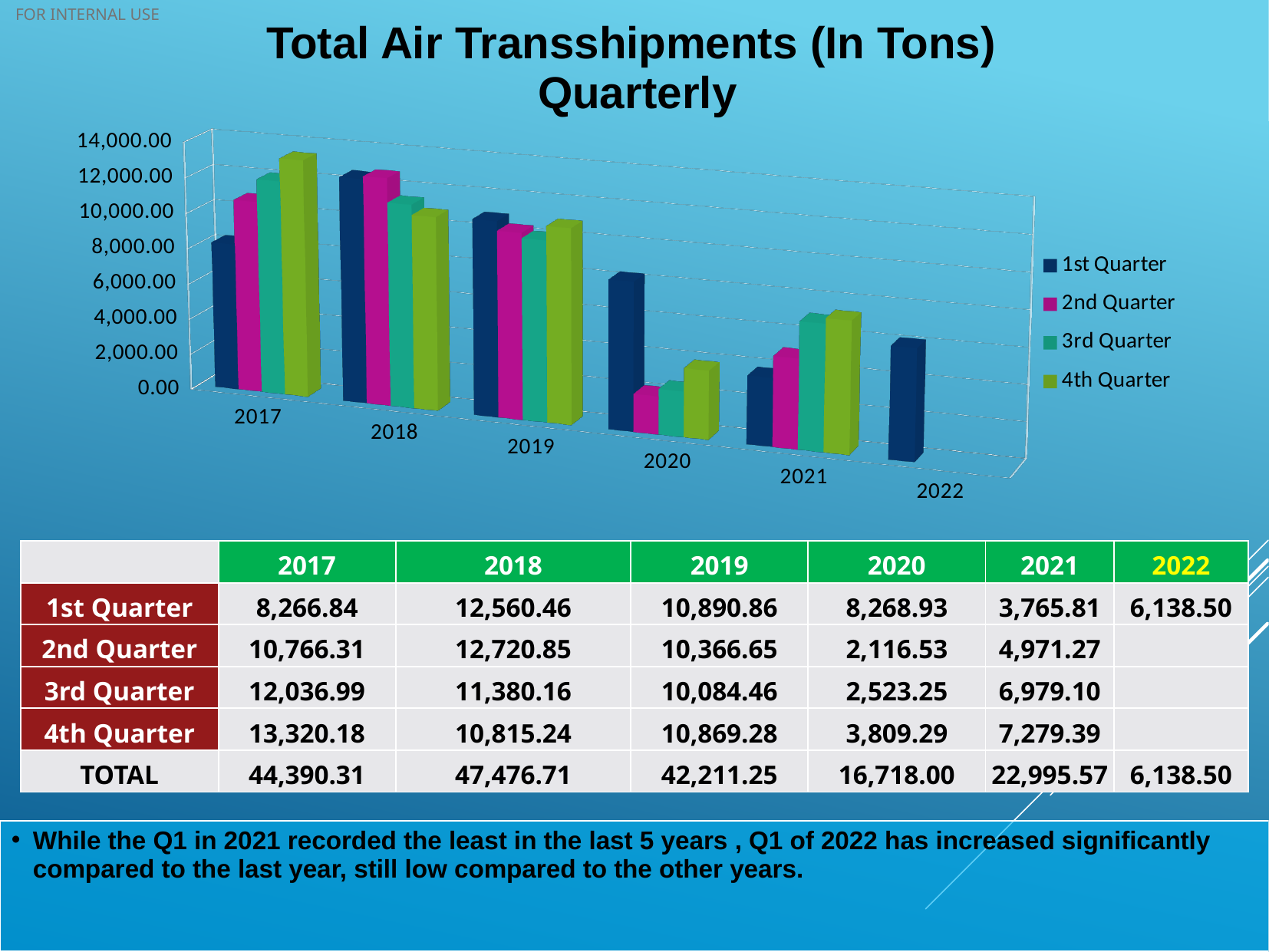
What kind of chart is shown on the slide? bar chart What is the title of the chart? Total Air Transshipments (In Tons) Quarterly Which is larger, the 4th Quarter value for 2017 or the 4th Quarter value for 2018? 2017 How many years are shown along the x axis of the chart? 6 What is the difference between the 1st Quarter value for 2022 and the 1st Quarter value for 2021? 2,372.69 What is the 4th Quarter value for 2017? 13,320.18 Is the 2nd Quarter value for 2020 greater or less than 4,000.00? less What is the 2nd Quarter value for 2020? 2,116.53 Does the 1st Quarter value rise or fall from 2018 to 2021? fall How many series does the chart legend list? 4 Which year has the highest 1st Quarter value? 2018 Which year has the lowest 1st Quarter value? 2021